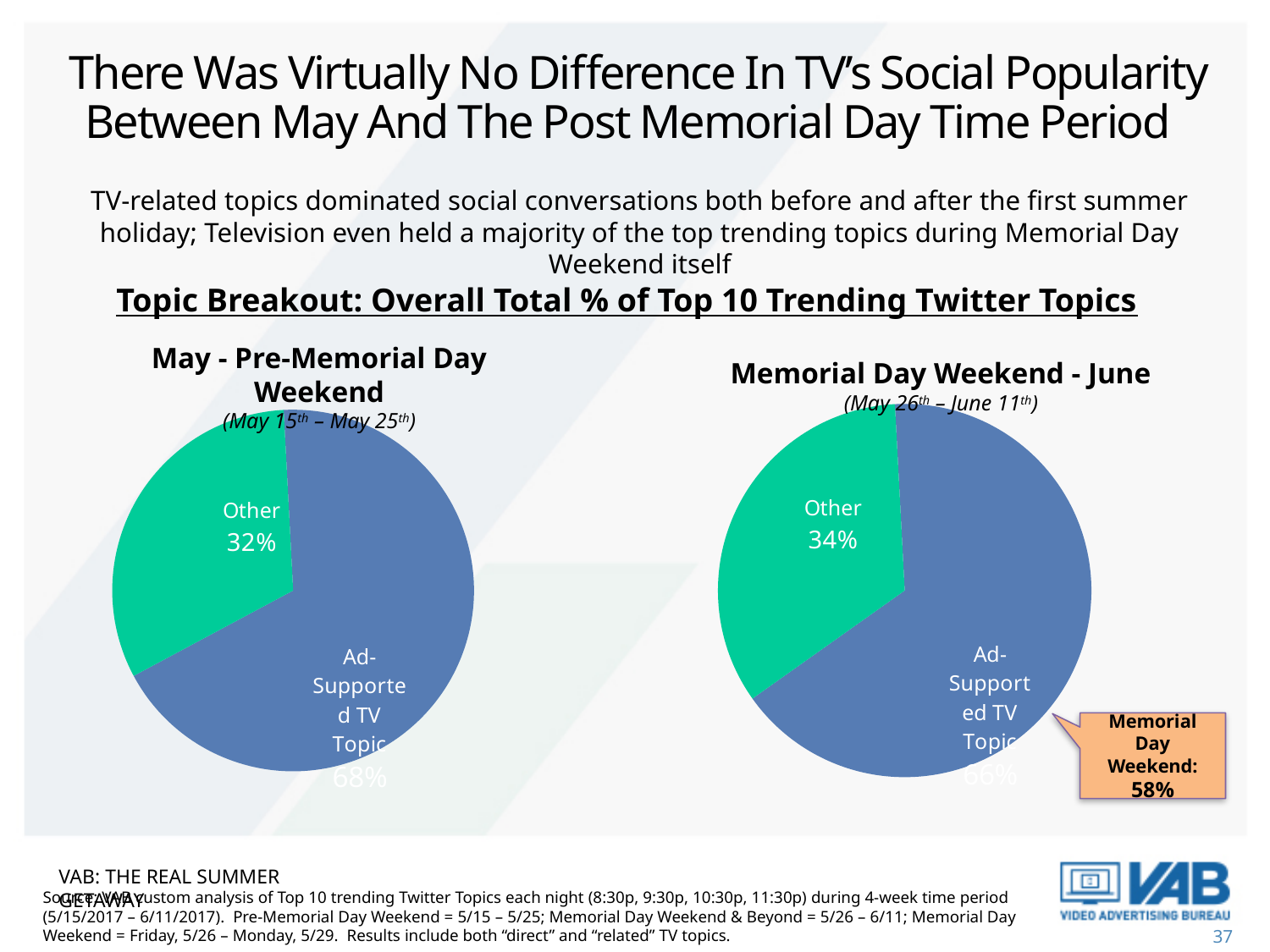
What type of chart is used for the 'May - Pre-Memorial Day Weekend' data? Pie chart In the 'Memorial Day Weekend - June' chart, what share of top trending Twitter topics is labeled 'Other'? 34% Is the 'Other' share larger in the 'May - Pre-Memorial Day Weekend' chart or the 'Memorial Day Weekend - June' chart? Memorial Day Weekend - June What date range is shown under the 'Memorial Day Weekend - June' chart title? May 26th – June 11th How many slices does the 'Memorial Day Weekend - June' pie chart have? 2 What is the difference between the 'Ad-Supported TV Topics' share in the 'May - Pre-Memorial Day Weekend' chart and in the 'Memorial Day Weekend - June' chart? 2% In the 'Memorial Day Weekend - June' chart, which slice is the smallest? Other In the 'Memorial Day Weekend - June' chart, what share is labeled 'Ad-Supported TV Topics'? 66% In the 'May - Pre-Memorial Day Weekend' chart, what share of top trending Twitter topics is labeled 'Other'? 32% In the 'May - Pre-Memorial Day Weekend' chart, which slice is the largest? Ad-Supported TV Topics In the 'May - Pre-Memorial Day Weekend' chart, what share is labeled 'Ad-Supported TV Topics'? 68% According to the callout next to the 'Memorial Day Weekend - June' chart, what was the Ad-Supported TV Topics share during Memorial Day Weekend itself? 58%